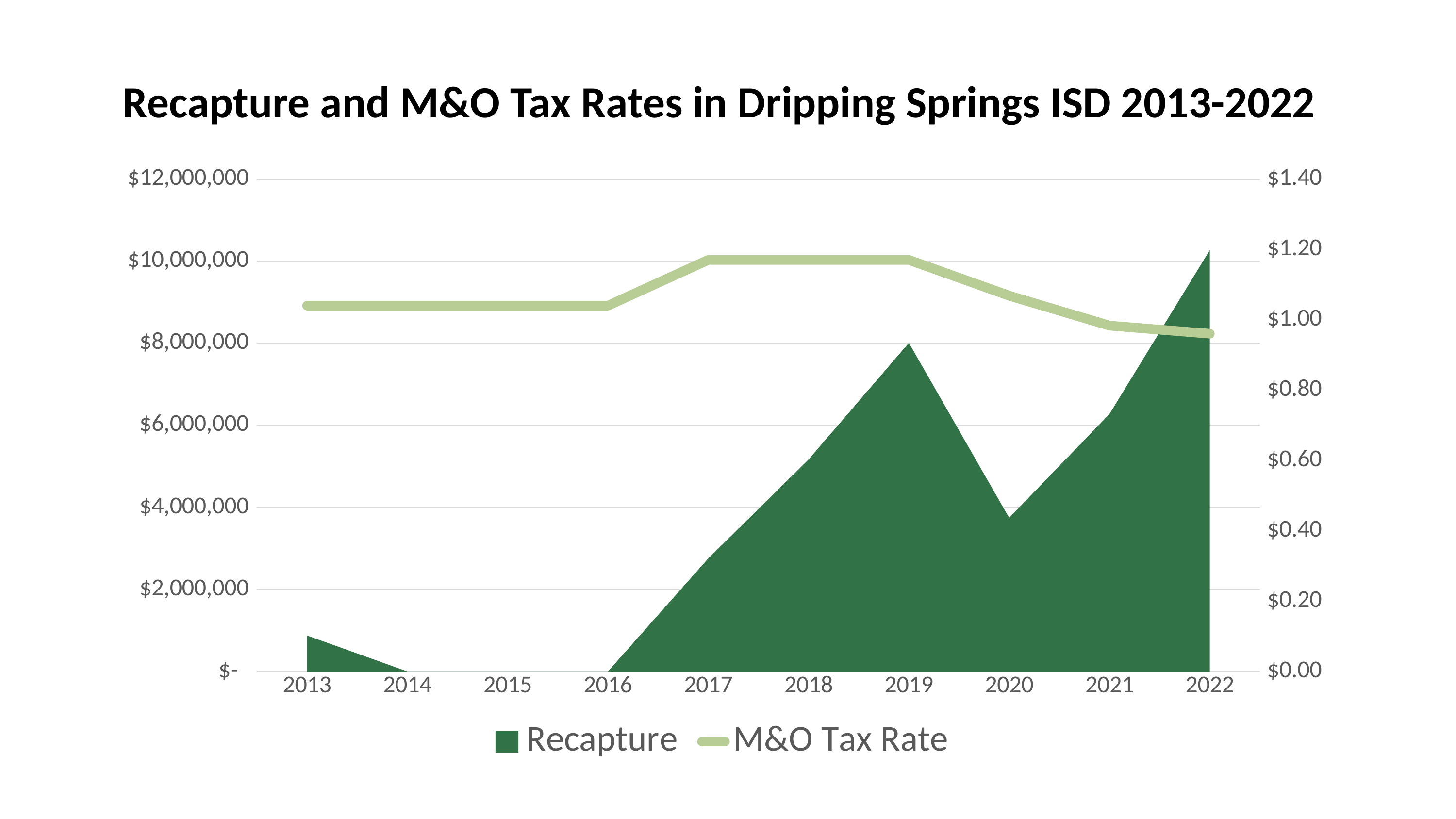
How many years are shown on the x axis? 10 In which year is Recapture highest? 2022 Which year has the larger Recapture value, 2019 or 2020? 2019 Is the Recapture value for 2022 greater or less than $8,000,000? greater Is the M&O Tax Rate for 2017 greater or less than $1.00? greater Is the Recapture value for 2013 greater or less than $2,000,000? less How many series does the legend list? 2 What is the title of the chart? Recapture and M&O Tax Rates in Dripping Springs ISD 2013-2022 Does the M&O Tax Rate rise or fall from 2019 to 2022? fall Does Recapture rise or fall from 2016 to 2019? rise What kind of chart is this? A combination area and line chart